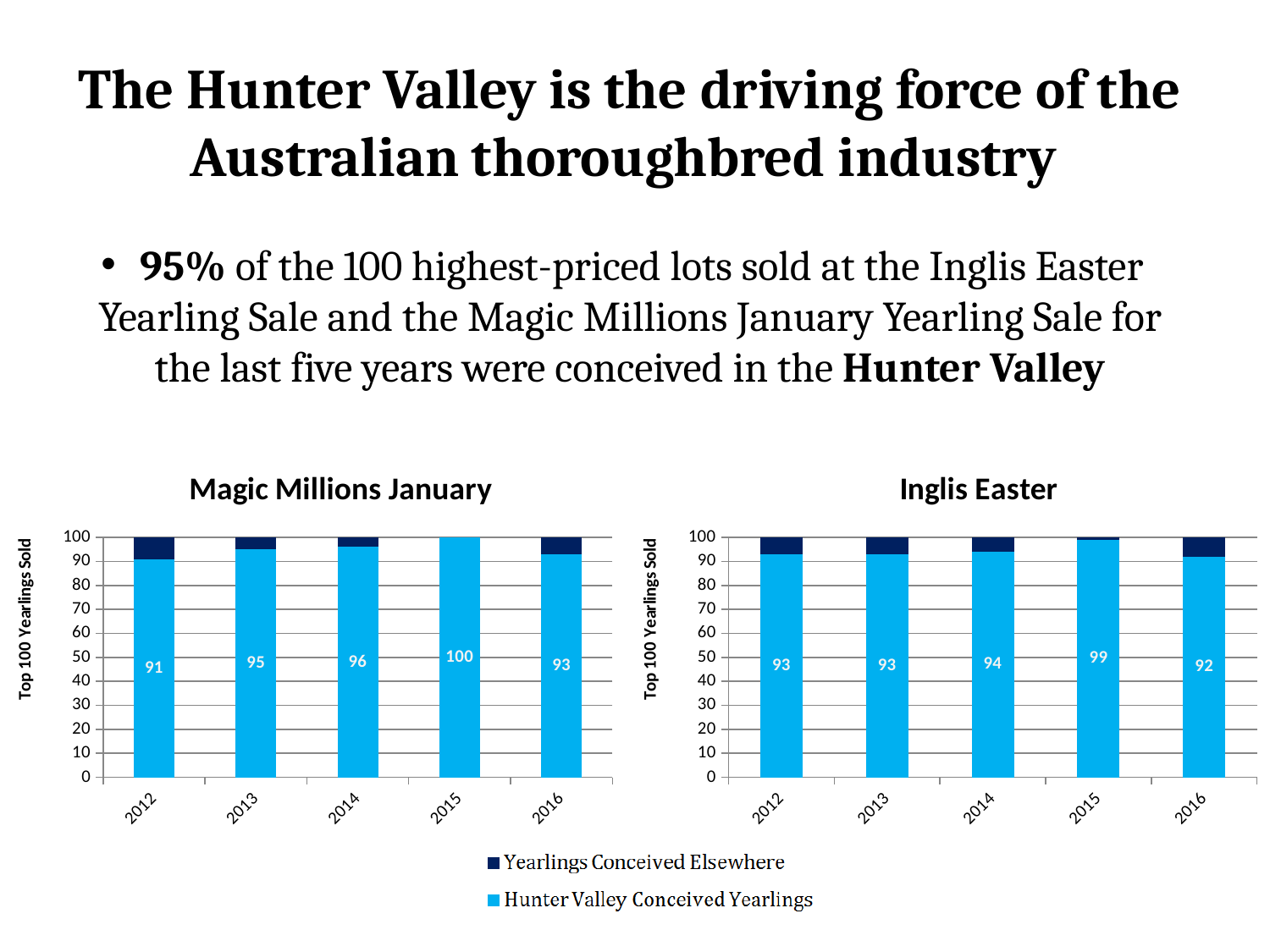
What kind of chart is the Magic Millions January chart? Stacked bar chart How many years are shown on the x axis of the Inglis Easter chart? 5 In the Inglis Easter chart, which year has the lowest number of Hunter Valley Conceived Yearlings? 2016 In the Inglis Easter chart, which year has more Hunter Valley Conceived Yearlings, 2014 or 2016? 2014 In the Magic Millions January chart, is the Hunter Valley Conceived Yearlings value for 2013 greater or less than 90? greater What is the y-axis label on the Inglis Easter chart? Top 100 Yearlings Sold In the Inglis Easter chart, what is the value for Hunter Valley Conceived Yearlings in 2015? 99 How many series does the legend list? 2 In the Magic Millions January chart, what is the difference between the Hunter Valley Conceived Yearlings values for 2015 and 2012? 9 In the Magic Millions January chart, what is the total height of the stacked bar for 2014? 100 In the Magic Millions January chart, how many Hunter Valley Conceived Yearlings were there in 2012? 91 In the Magic Millions January chart, which year has the highest number of Hunter Valley Conceived Yearlings? 2015